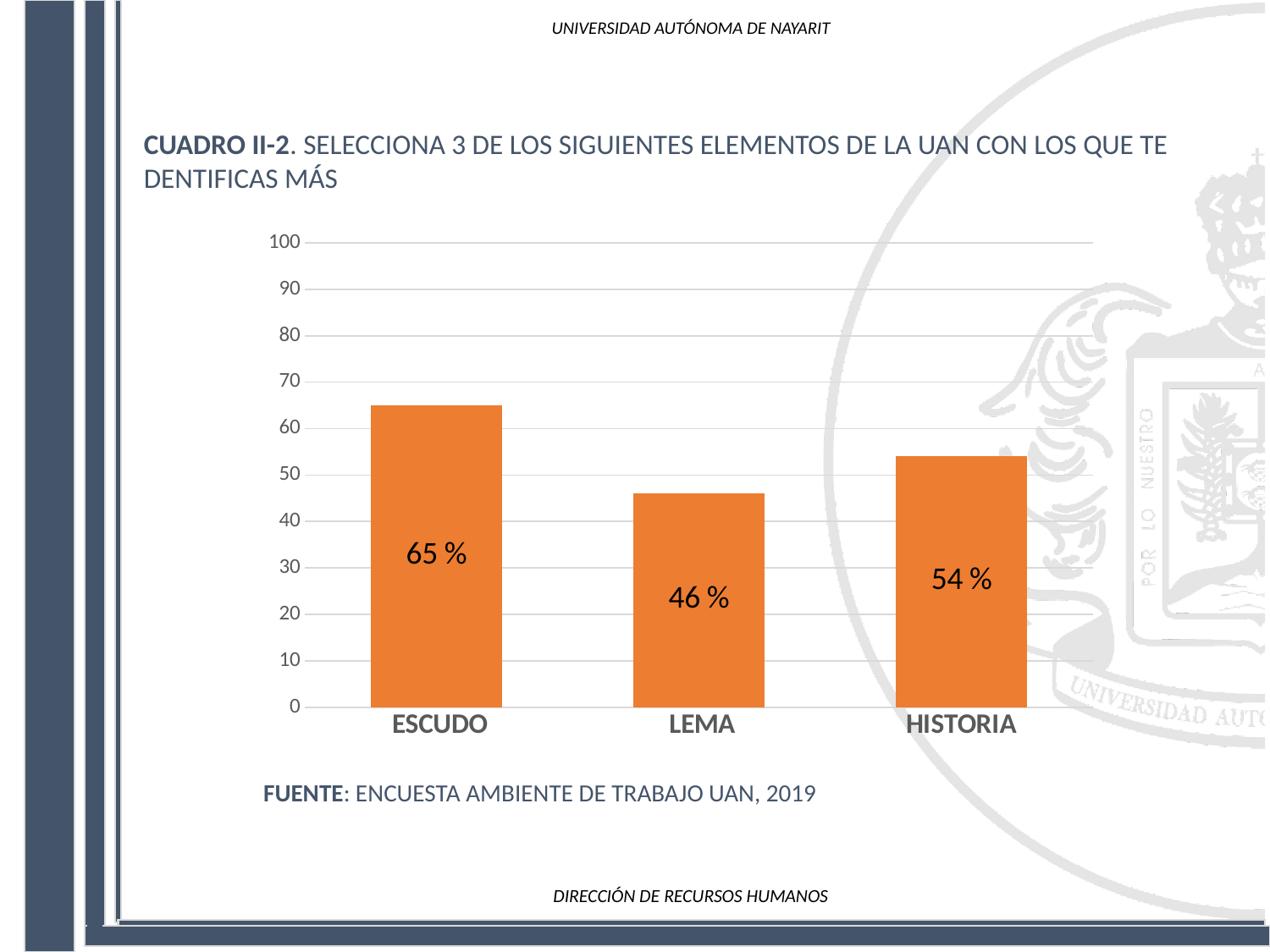
What is the difference between the values for ESCUDO and LEMA? 19 % How many categories are shown on the x axis? 3 What is the difference between the values for HISTORIA and LEMA? 8 % What is the value for LEMA? 46 % Which category has the lowest value? LEMA What kind of chart is shown on the slide? bar chart What is the value for ESCUDO? 65 % Which is larger, the value for HISTORIA or the value for LEMA? HISTORIA Is the value for ESCUDO greater or less than 60? greater Which category has the highest value? ESCUDO What source is cited below the chart? ENCUESTA AMBIENTE DE TRABAJO UAN, 2019 What is the value for HISTORIA? 54 %